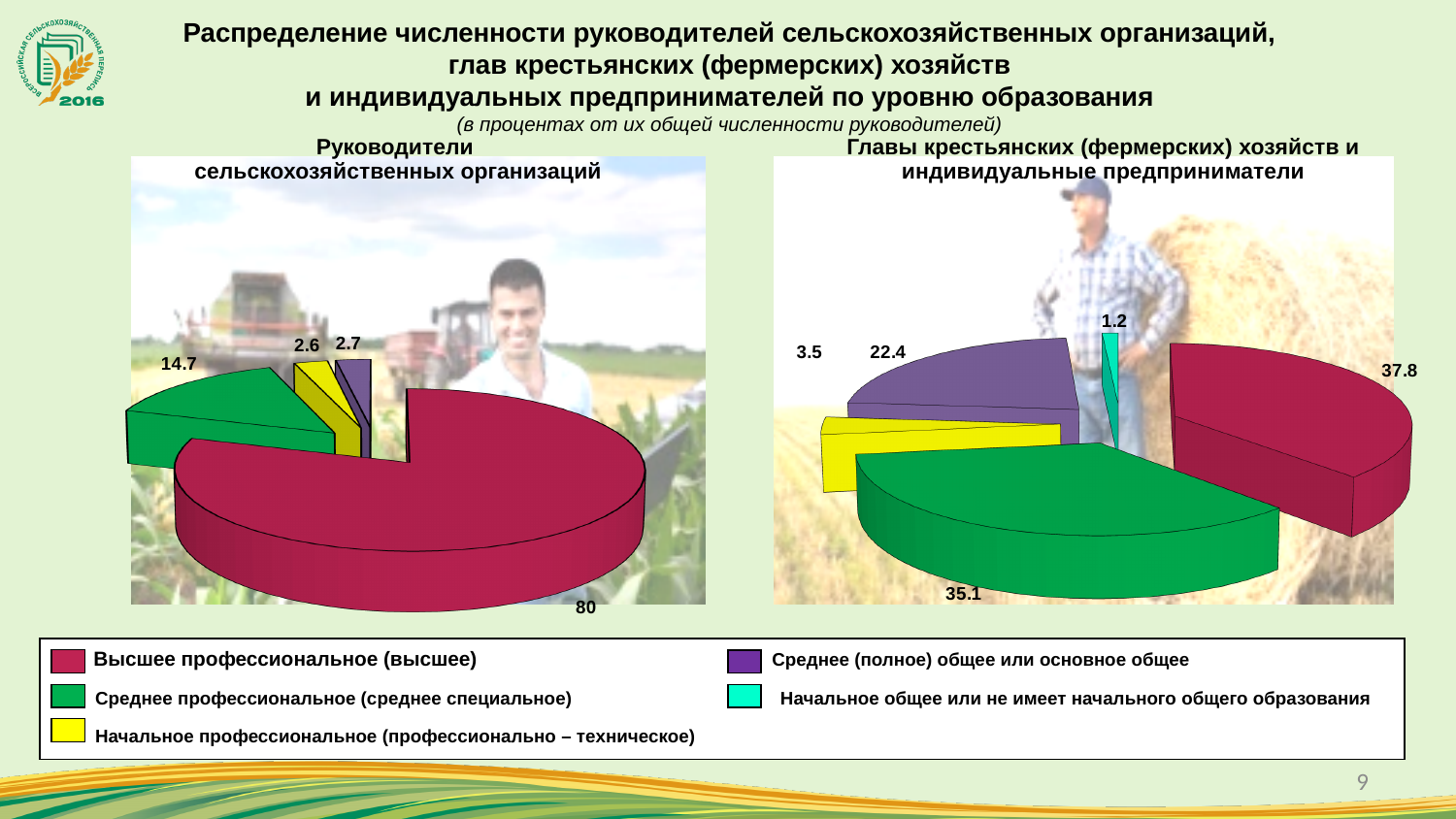
What type of charts are shown on the slide? Pie charts In the left pie chart (Руководители сельскохозяйственных организаций), what is the value for Высшее профессиональное (высшее)? 80 In the right pie chart (Главы крестьянских (фермерских) хозяйств и индивидуальные предприниматели), which category has the largest share? Высшее профессиональное (высшее) In the right pie chart (Главы крестьянских (фермерских) хозяйств и индивидуальные предприниматели), what is the difference between Высшее профессиональное (высшее) and Среднее профессиональное (среднее специальное)? 2.7 In the left pie chart (Руководители сельскохозяйственных организаций), which category has the largest share? Высшее профессиональное (высшее) How many categories does the legend list? 5 Is the value for Среднее профессиональное (среднее специальное) larger in the left pie chart or in the right pie chart? Right pie chart In the left pie chart (Руководители сельскохозяйственных организаций), what is the value for Среднее профессиональное (среднее специальное)? 14.7 In the right pie chart (Главы крестьянских (фермерских) хозяйств и индивидуальные предприниматели), which category has the smallest share? Начальное общее или не имеет начального общего образования In the right pie chart (Главы крестьянских (фермерских) хозяйств и индивидуальные предприниматели), what is the value for Среднее (полное) общее или основное общее? 22.4 What is the difference between the value for Высшее профессиональное (высшее) in the left pie chart and in the right pie chart? 42.2 In the right pie chart (Главы крестьянских (фермерских) хозяйств и индивидуальные предприниматели), what is the value for Начальное общее или не имеет начального общего образования? 1.2